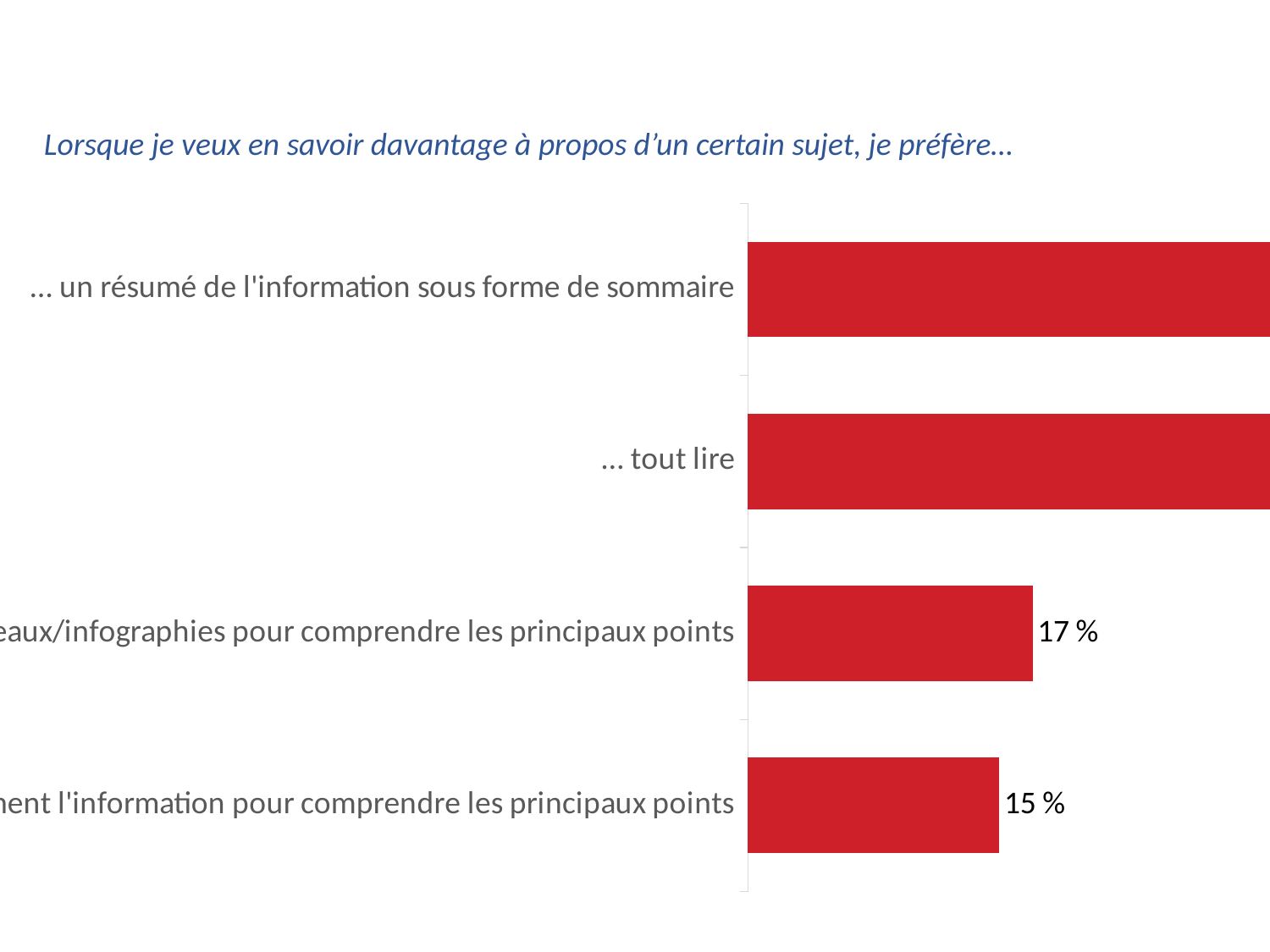
What is the value shown for the third bar from the top (the category ending in 'infographies pour comprendre les principaux points')? 17 % What colour are the bars in the chart? red What is the title of the chart? Lorsque je veux en savoir davantage à propos d’un certain sujet, je préfère… What is the difference between the value of the third bar from the top (17 %) and the bottom bar (15 %)? 2 % Which is larger: the value for '… tout lire' or the value of the third bar from the top (17 %)? … tout lire What is the value shown for the bottom bar (the category ending in 'l'information pour comprendre les principaux points')? 15 % Which bar has the lowest value in the chart? the bottom bar (15 %) How many categories (bars) does the chart show? 4 Which is larger: the value of the third bar from the top or the value of the bottom bar? the third bar from the top (17 %) What kind of chart is shown on the slide? bar chart